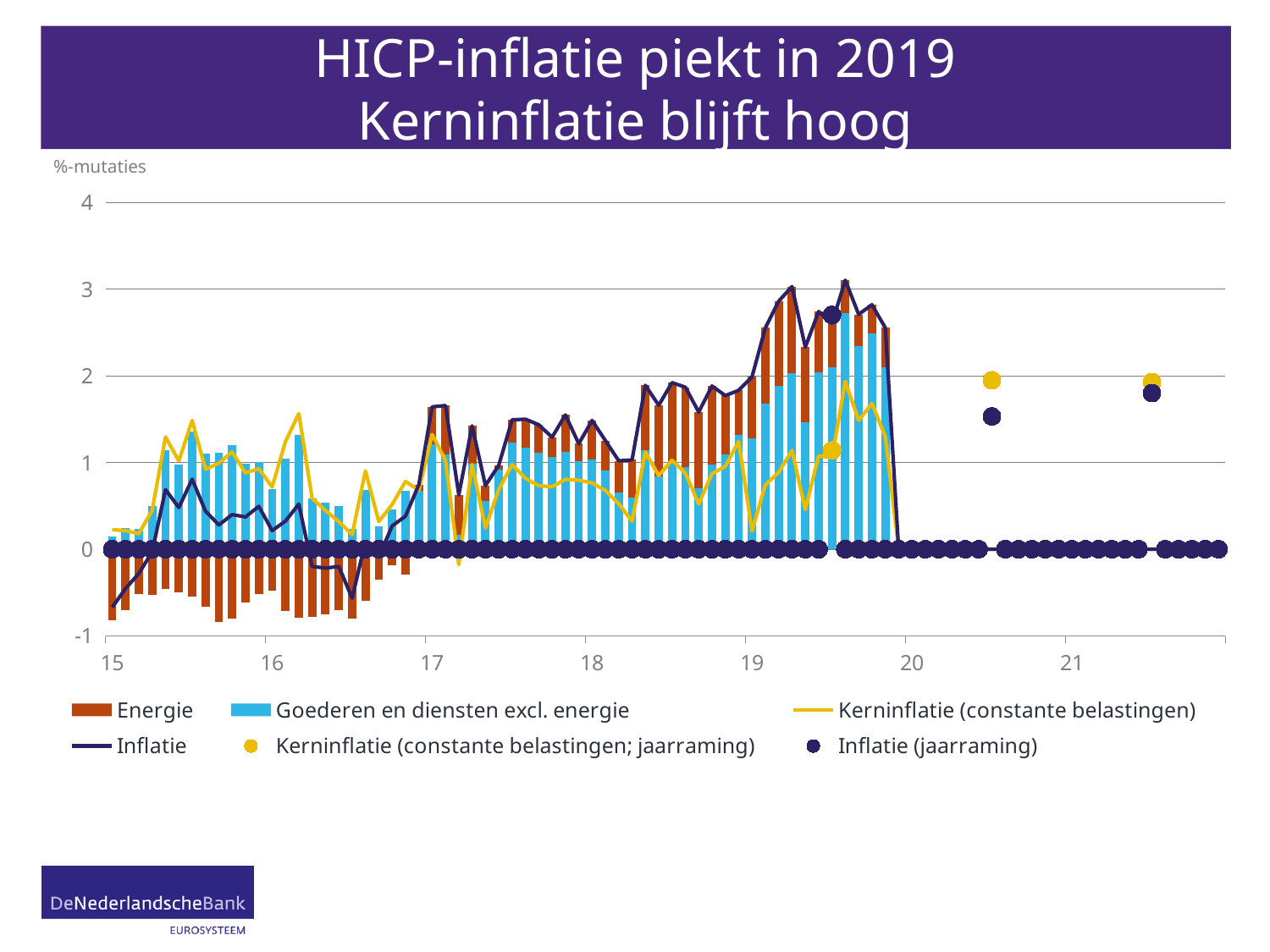
For 2019, which annual forecast dot is higher: Kerninflatie (constante belastingen; jaarraming) or Inflatie (jaarraming)? Inflatie (jaarraming) What is the title of the chart on the slide? HICP-inflatie piekt in 2019 Kerninflatie blijft hoog In which year does the Inflatie line reach its highest point? 2019 Is the value of the Inflatie (jaarraming) dot for 2019 greater or less than 3? less What unit label is shown above the vertical axis? %-mutaties How many series does the legend list? 6 Is the value of the Inflatie (jaarraming) dot for 2020 greater or less than 2? less For 2020, which annual forecast dot is higher: Kerninflatie (constante belastingen; jaarraming) or Inflatie (jaarraming)? Kerninflatie (constante belastingen; jaarraming) Is the value of the Inflatie (jaarraming) dot for 2019 greater or less than 2? greater What kind of chart is shown on the slide? A combination chart with stacked bars, lines and dot markers